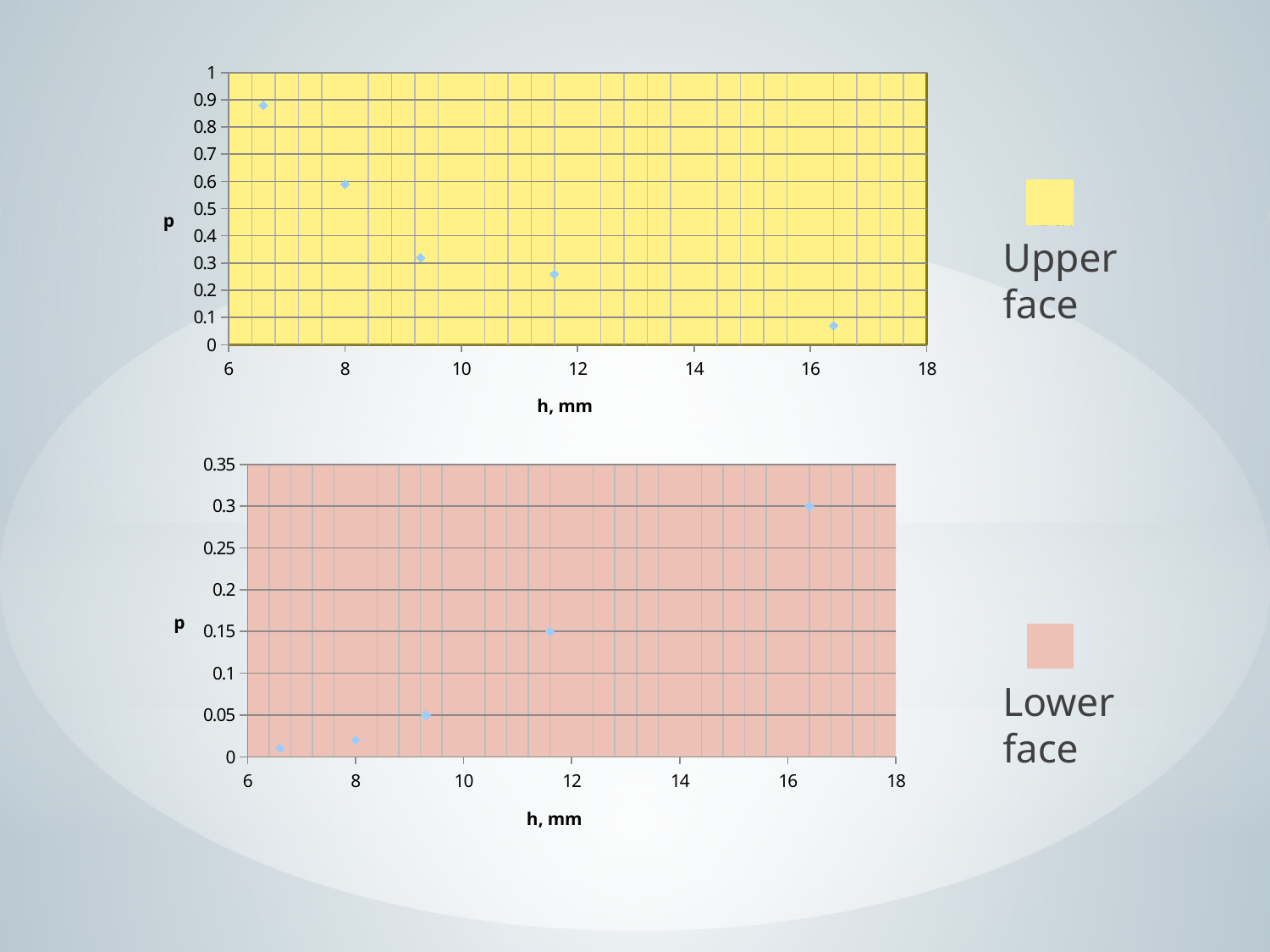
In the lower chart, is the value of p for the point nearest h = 12 greater or less than 0.2? less In the upper chart, is the value of p for the point nearest h = 16 greater or less than 0.1? less In the upper chart, is the value of p for the point nearest h = 8 greater or less than 0.5? greater In the lower chart, do the values of p rise or fall as h increases? rise In the upper chart, do the values of p rise or fall as h increases? fall How many data points are plotted in the lower chart (pink background)? 5 What is the label of the x axis on the lower chart? h, mm What kind of chart is the upper chart on the slide? scatter chart How many data points are plotted in the upper chart (yellow background)? 5 Which face does the pink chart represent according to the legend on the slide? Lower face In the upper chart, which point has the highest value of p: the one nearest h = 8 or the one nearest h = 12? the one nearest h = 8